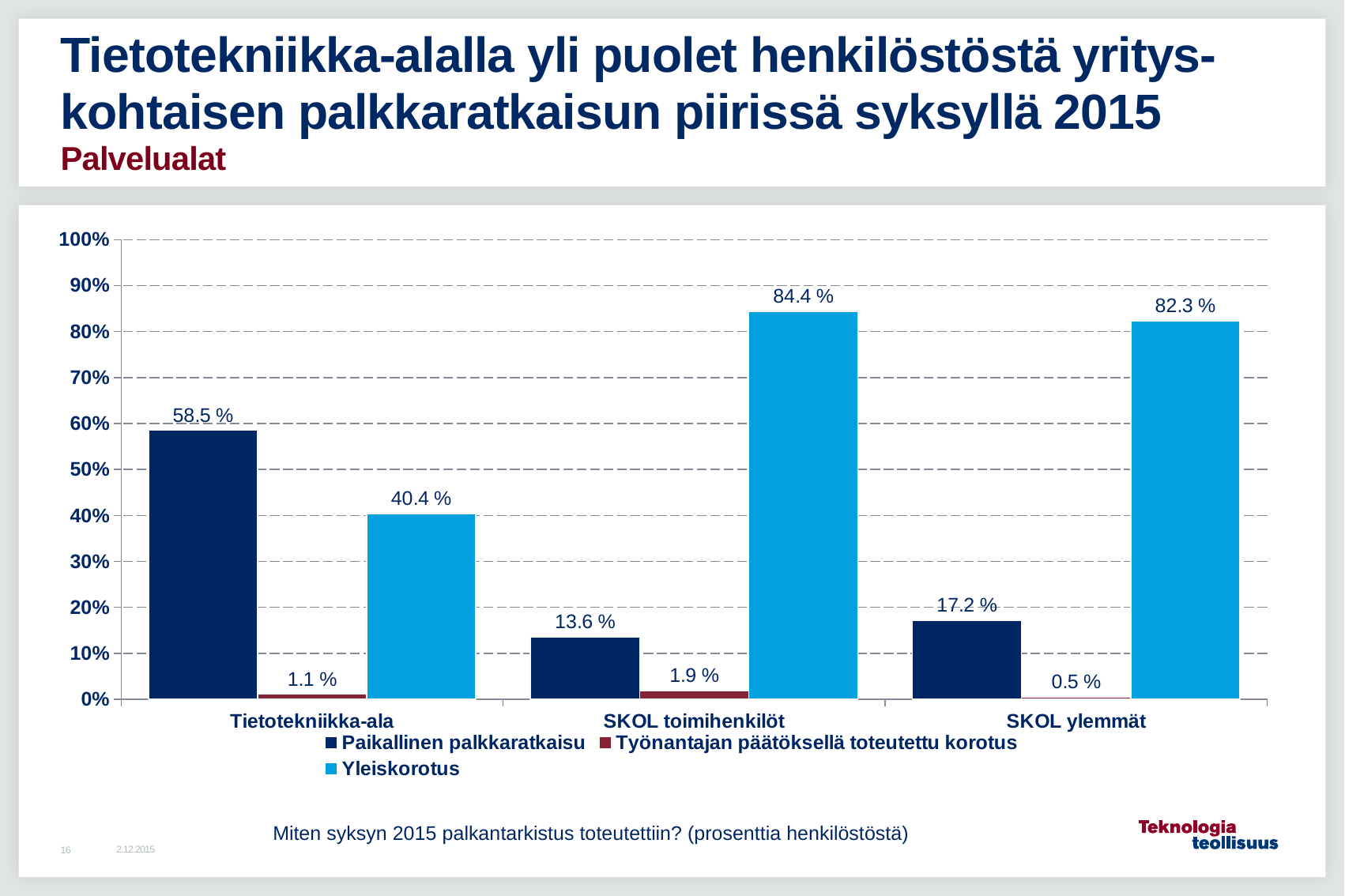
Which is larger for SKOL ylemmät: Paikallinen palkkaratkaisu or Yleiskorotus? Yleiskorotus Which category has the lowest value for Paikallinen palkkaratkaisu? SKOL toimihenkilöt How many categories are shown on the x axis? 3 What is the difference between Yleiskorotus and Paikallinen palkkaratkaisu for Tietotekniikka-ala? 18.1 % Which category has the highest value for Yleiskorotus? SKOL toimihenkilöt What kind of chart is shown on the slide? Bar chart How many series does the legend list? 3 What is the value of Työnantajan päätöksellä toteutettu korotus for SKOL ylemmät? 0.5 % What is the value of Yleiskorotus for SKOL toimihenkilöt? 84.4 % What is the difference between Työnantajan päätöksellä toteutettu korotus for SKOL toimihenkilöt and Tietotekniikka-ala? 0.8 % What is the value of Paikallinen palkkaratkaisu for Tietotekniikka-ala? 58.5 % What is the value of Paikallinen palkkaratkaisu for SKOL ylemmät? 17.2 %